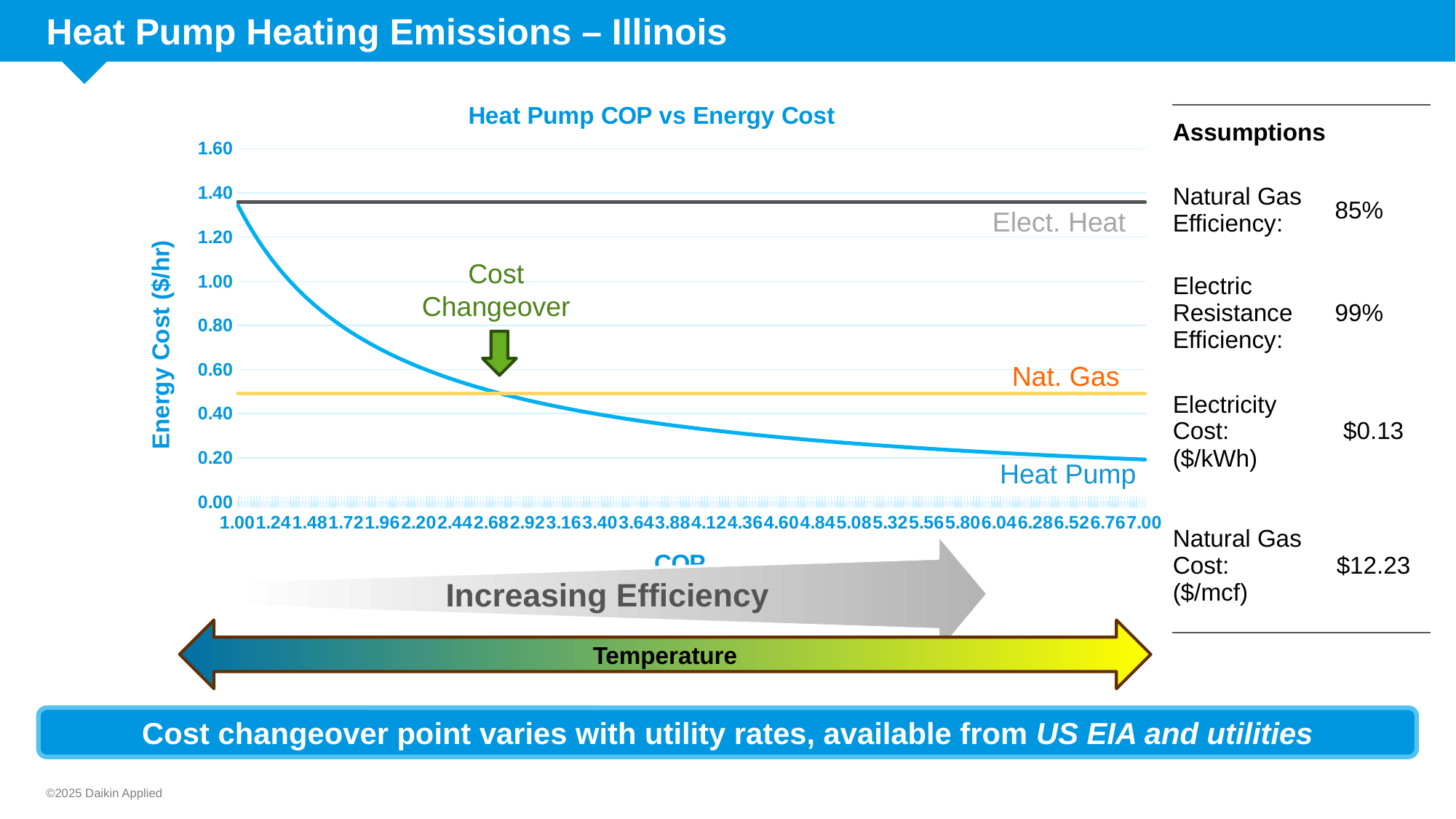
What kind of chart is shown on the slide? Line chart Which two lines cross at the point marked Cost Changeover? Heat Pump and Nat. Gas Which line has the highest energy cost across the chart? Elect. Heat Is the Heat Pump energy cost at a COP of 7.00 greater or less than 0.40? less Which is larger, the energy cost for Elect. Heat or for Nat. Gas? Elect. Heat What is the label on the vertical axis of the chart? Energy Cost ($/hr) Is the energy cost for Nat. Gas greater or less than 0.60? less Does the Heat Pump line rise or fall as COP increases along the x axis? Fall Is the energy cost for Elect. Heat greater or less than 1.20? greater How many lines (series) are plotted on the chart? 3 What is the title of the chart? Heat Pump COP vs Energy Cost Which line has the lowest energy cost at a COP of 7.00? Heat Pump